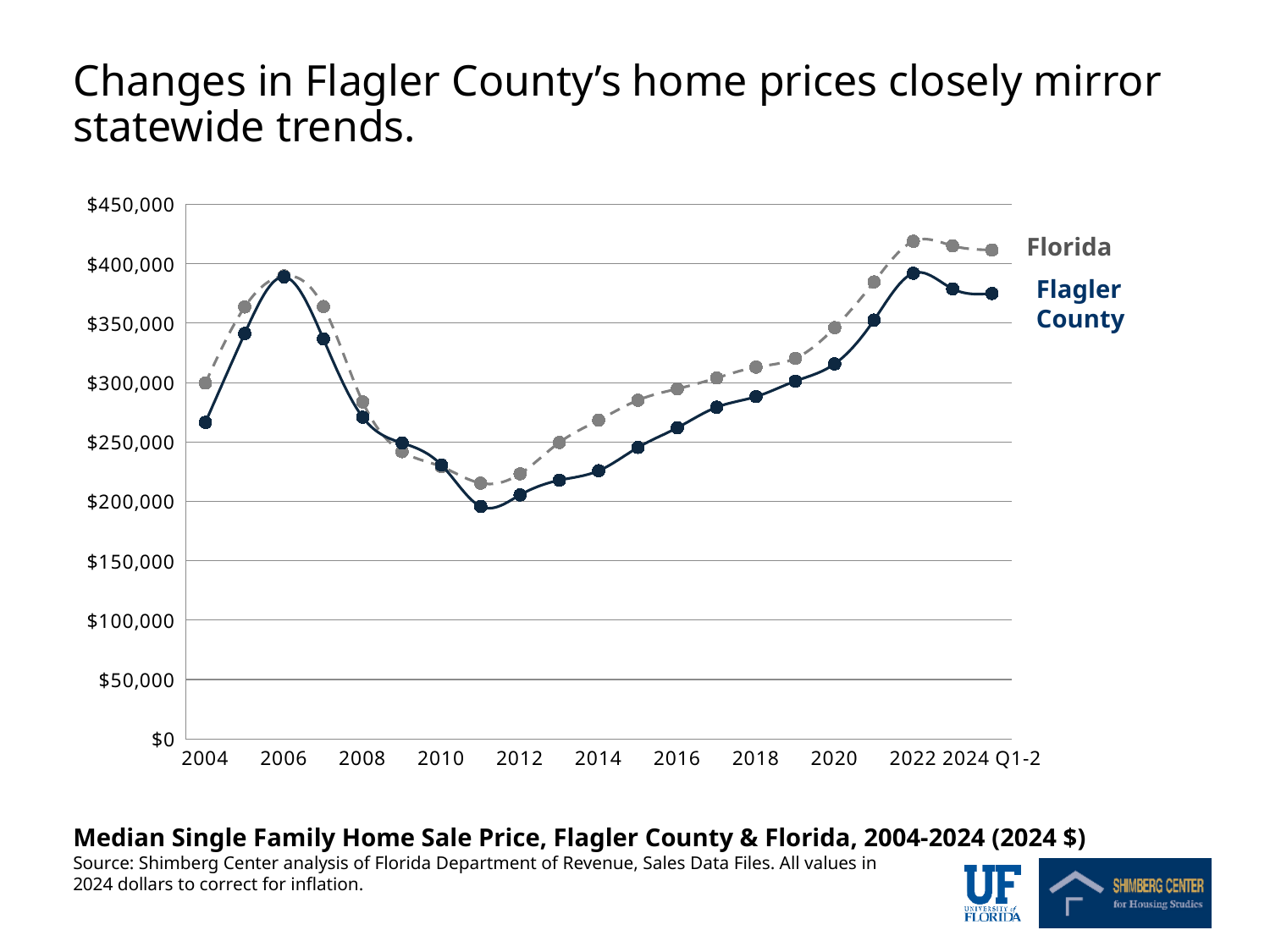
Is the Flagler County value for 2004 greater or less than $250,000? greater What is the title of the chart? Median Single Family Home Sale Price, Flagler County & Florida, 2004-2024 (2024 $) In which year does the Florida series reach its highest value? 2022 In 2014, which is higher: the Florida value or the Flagler County value? Florida Is the Florida value for 2022 greater or less than $400,000? greater Does the Flagler County series rise or fall between 2011 and 2022? Rise In which year does the Flagler County series reach its lowest value? 2011 How many series does the chart show? 2 Which two series are plotted on the chart? Florida and Flagler County What kind of chart is shown on the slide? Line chart Is the Flagler County value for 2006 greater or less than $350,000? greater